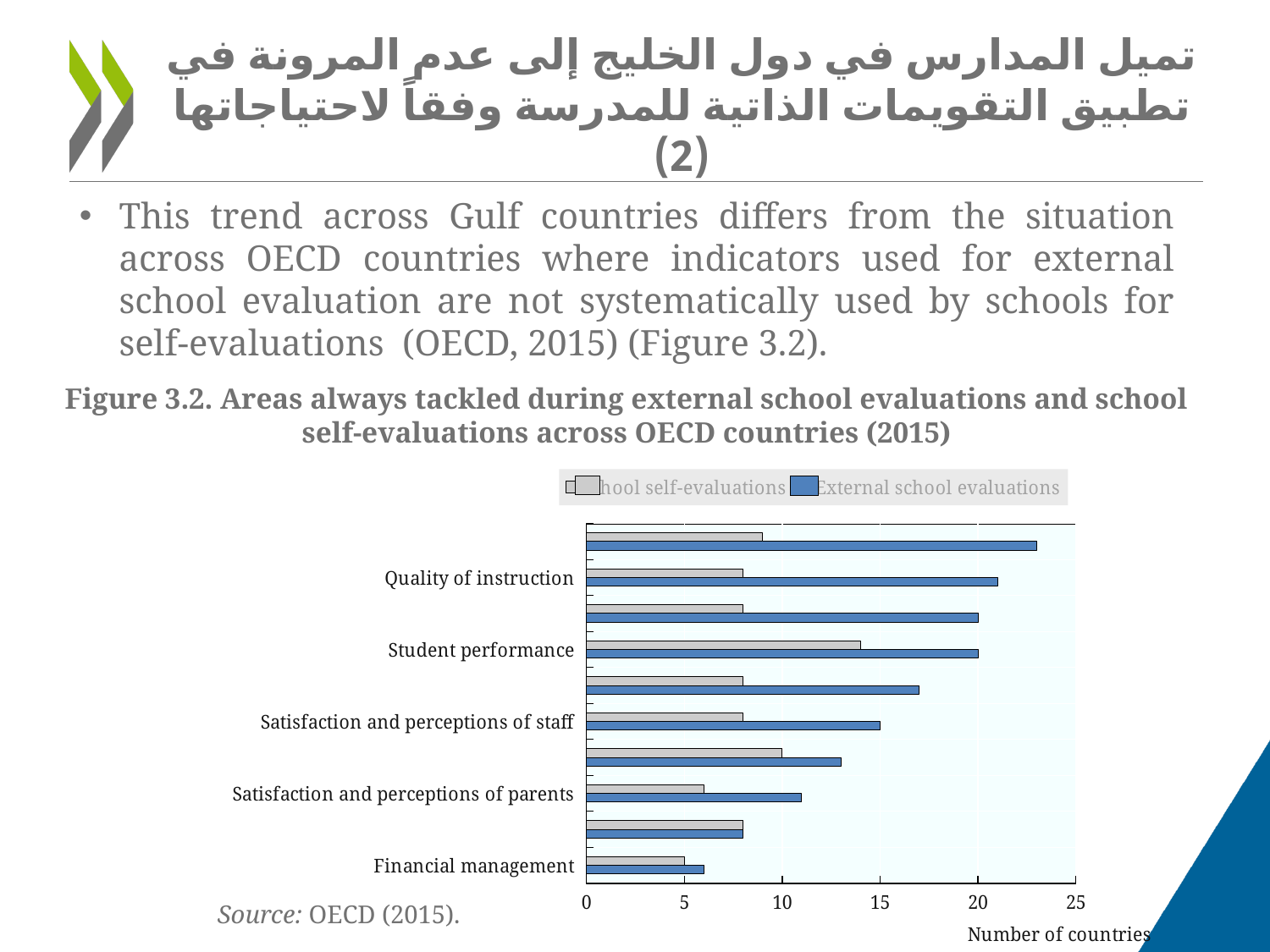
In Figure 3.2, is the School self-evaluations value for Student performance greater or less than 10? greater In Figure 3.2, is the External school evaluations value for Financial management greater or less than 10? less In Figure 3.2, is the External school evaluations value for Quality of instruction greater or less than 15? greater Which series in Figure 3.2 is shown in blue? External school evaluations How many series does the legend of Figure 3.2 list? 2 In Figure 3.2, for Student performance, which series has the larger value: School self-evaluations or External school evaluations? External school evaluations What is the title of the horizontal axis in Figure 3.2? Number of countries In Figure 3.2, among the labelled categories, which has the lowest External school evaluations value? Financial management In Figure 3.2, for Quality of instruction, which series has the larger value: School self-evaluations or External school evaluations? External school evaluations What kind of chart is shown in Figure 3.2? Bar chart